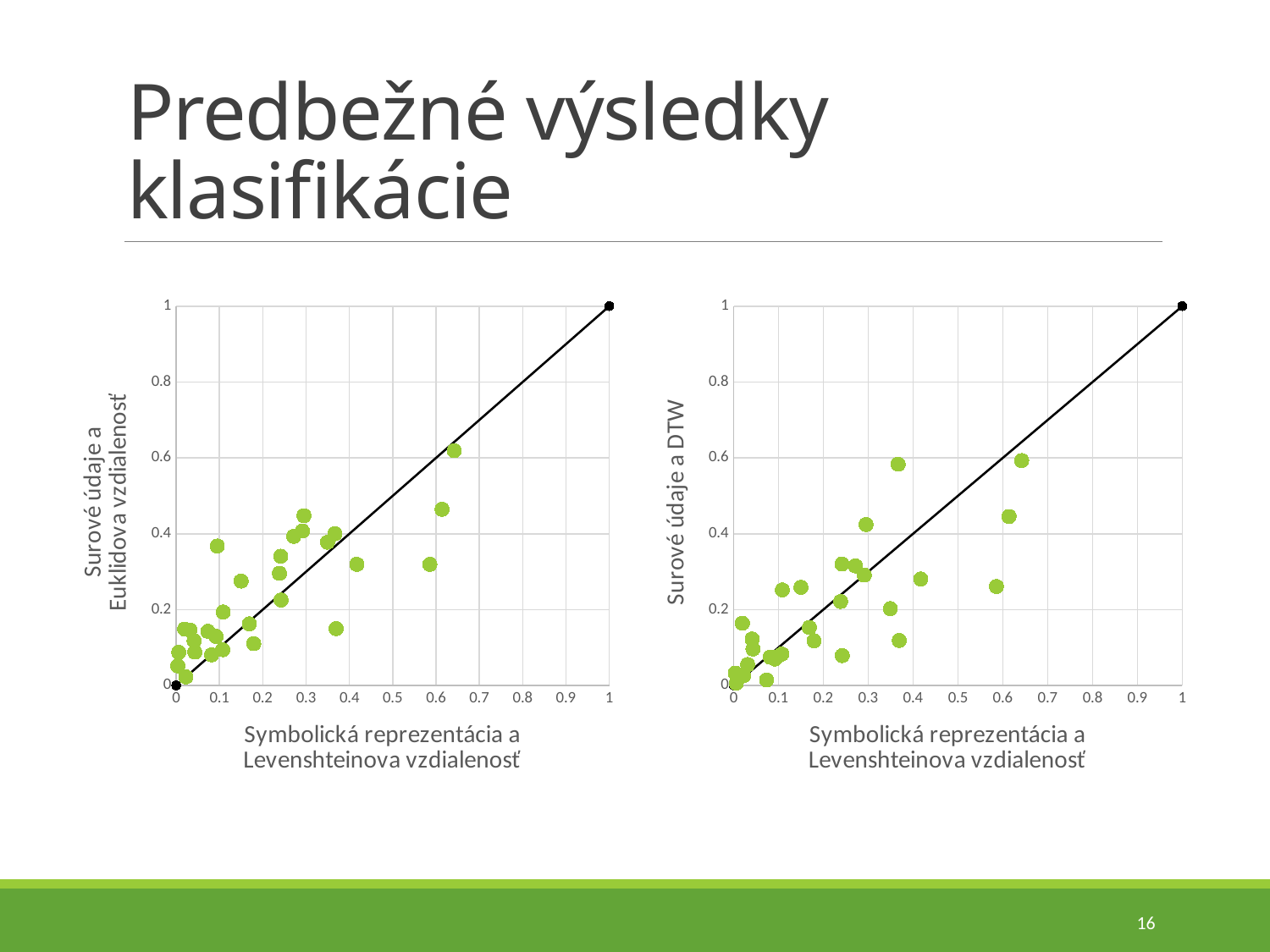
In the right chart, is the y value of the highest green point greater or less than 0.8? less In the left chart, what is the y value of the black point at the upper end of the diagonal line, where x = 1? 1 What is the maximum value shown on the y axis of the right chart? 1 What kind of chart is the left chart on the slide? scatter chart In the right chart, is the y value of the green point with the largest x value (near x = 0.64) greater or less than 0.5? greater What kind of chart is the right chart on the slide? scatter chart In the left chart, is the y value of the highest green point greater or less than 0.5? greater In the left chart, do the green points generally rise or fall as the x value increases? rise In the right chart, what is the y value of the black point at the lower end of the diagonal line, where x = 0? 0 What is the y-axis label of the right chart? Surové údaje a DTW